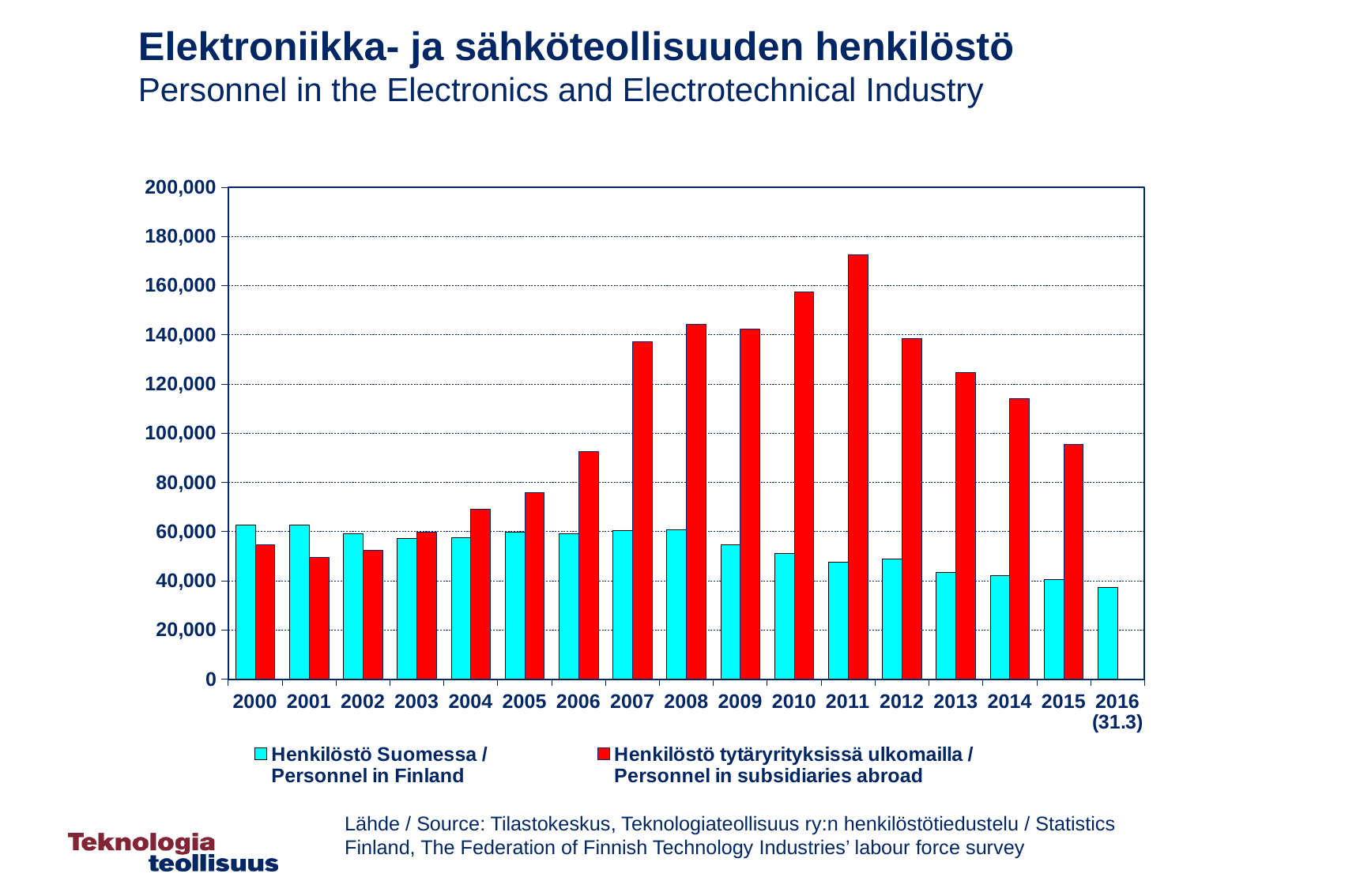
Is the value for Personnel in subsidiaries abroad in 2015 greater or less than 100,000? less In 2010, which is larger: Personnel in Finland or Personnel in subsidiaries abroad? Personnel in subsidiaries abroad How many years are shown on the x axis? 17 In 2000, which is larger: Personnel in Finland or Personnel in subsidiaries abroad? Personnel in Finland In which year is Personnel in Finland lowest? 2016 (31.3) How many series does the legend list? 2 Is the value for Personnel in subsidiaries abroad in 2011 greater or less than 160,000? greater Does Personnel in Finland rise or fall from 2008 to 2016? fall Is the value for Personnel in subsidiaries abroad in 2007 greater or less than 120,000? greater In which year is Personnel in subsidiaries abroad highest? 2011 What kind of chart is shown on the slide? bar chart